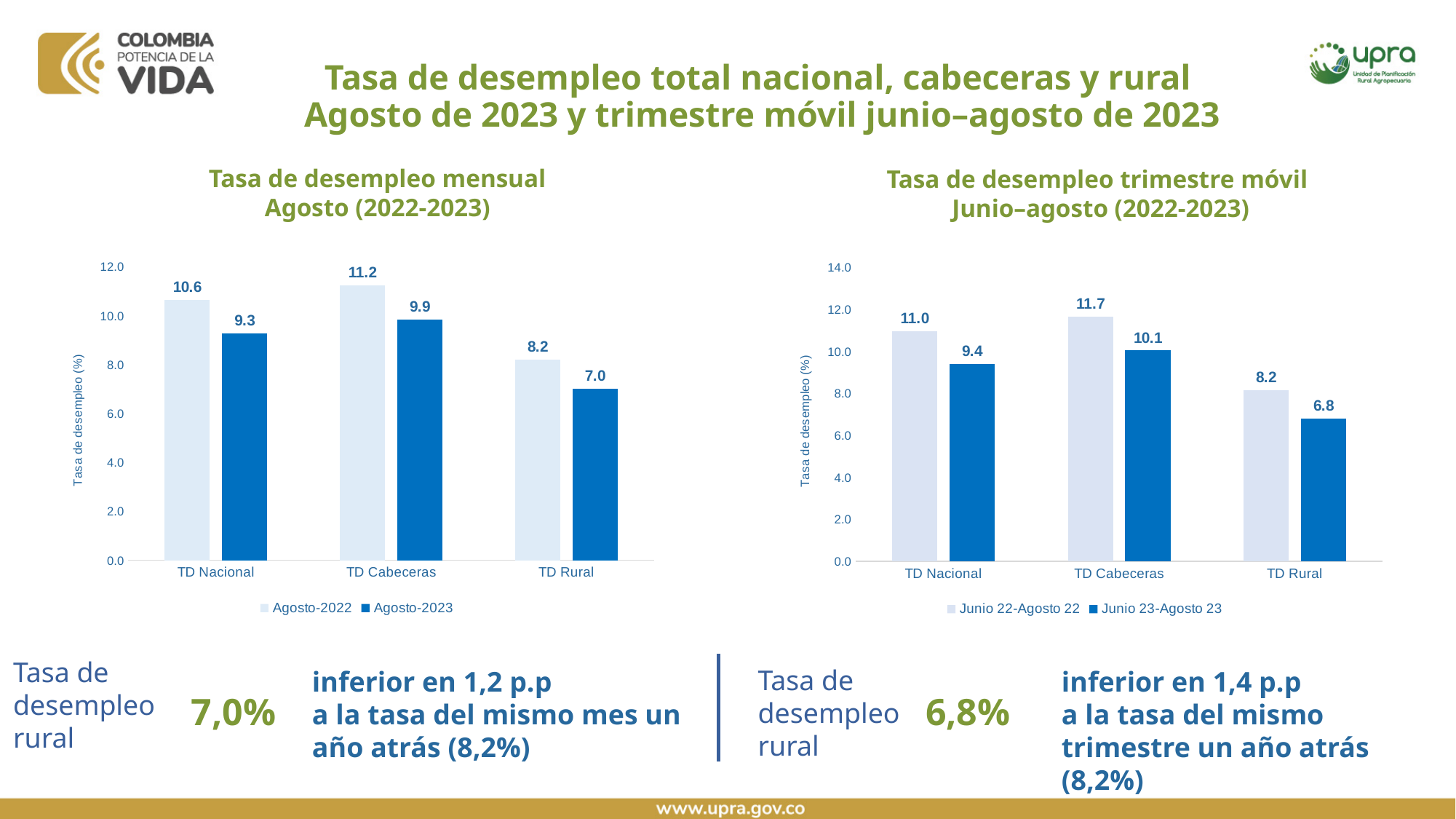
In the left chart (Tasa de desempleo mensual Agosto), what is the value for TD Nacional in Agosto-2023? 9.3 In the right chart (Tasa de desempleo trimestre móvil Junio–agosto), what is the difference between the Junio 22-Agosto 22 and Junio 23-Agosto 23 values for TD Nacional? 1.6 In the left chart (Tasa de desempleo mensual Agosto), which category has the highest value for Agosto-2023? TD Cabeceras In the right chart (Tasa de desempleo trimestre móvil Junio–agosto), which category has the lowest value for Junio 23-Agosto 23? TD Rural In the right chart (Tasa de desempleo trimestre móvil Junio–agosto), how many categories are shown on the x axis? 3 In the right chart (Tasa de desempleo trimestre móvil Junio–agosto), what is the value for TD Rural in Junio 22-Agosto 22? 8.2 In the right chart (Tasa de desempleo trimestre móvil Junio–agosto), what is the value for TD Cabeceras in Junio 23-Agosto 23? 10.1 In the left chart (Tasa de desempleo mensual Agosto), how many series does the legend list? 2 In the right chart (Tasa de desempleo trimestre móvil Junio–agosto), which is larger: TD Nacional in Junio 23-Agosto 23 or TD Rural in Junio 22-Agosto 22? TD Nacional in Junio 23-Agosto 23 In the left chart (Tasa de desempleo mensual Agosto), what is the value for TD Cabeceras in Agosto-2022? 11.2 What kind of chart is the left chart (Tasa de desempleo mensual Agosto)? Bar chart In the left chart (Tasa de desempleo mensual Agosto), what is the difference between the Agosto-2022 and Agosto-2023 values for TD Rural? 1.2